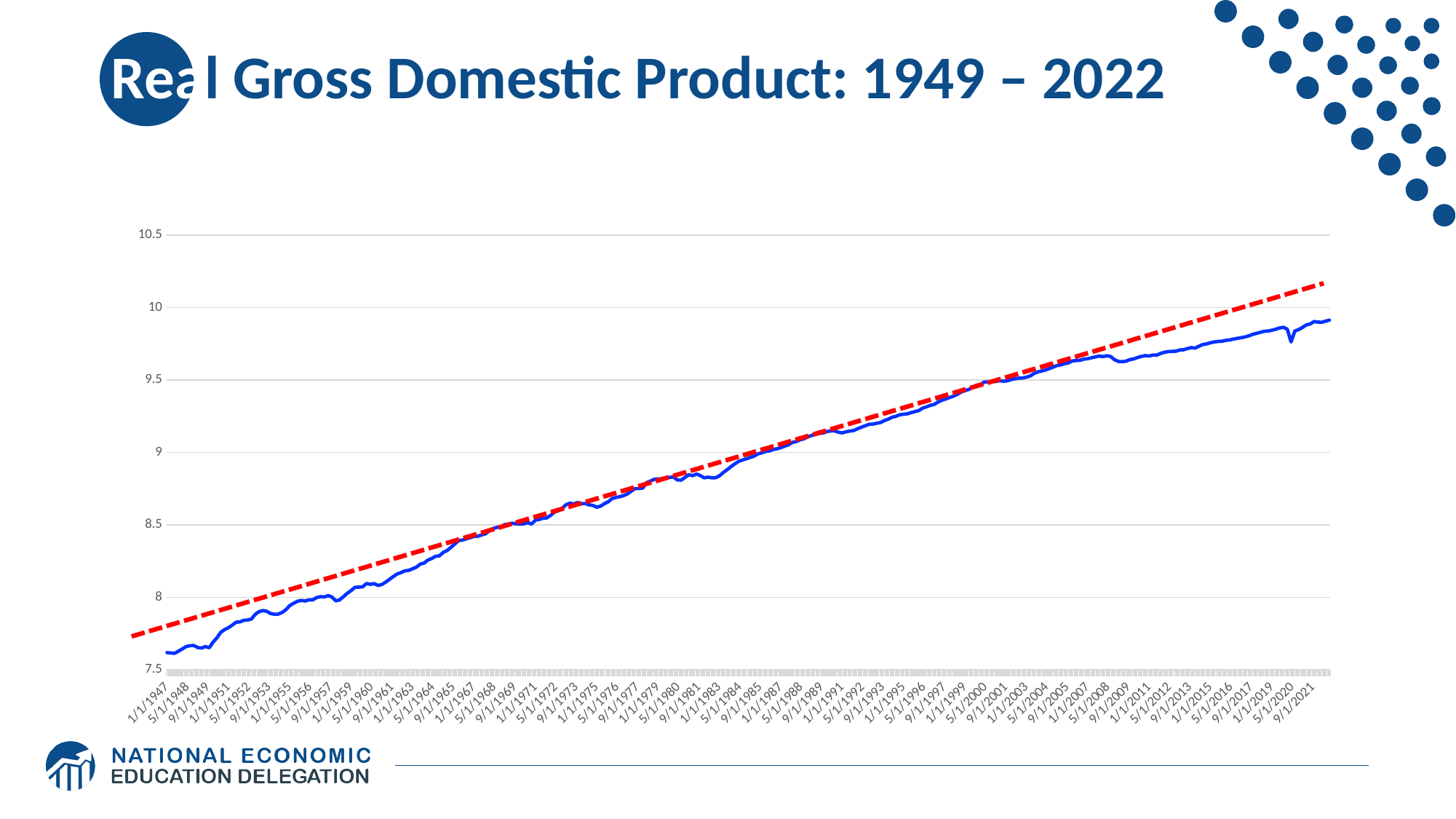
Which is higher at 1/1/1947, the red dashed line or the blue line? the red dashed line Is the value of the blue line at 1/1/1965 greater or less than 8.5? less What is the highest value shown on the y axis? 10.5 What kind of chart is shown on the slide? line chart Is the value of the blue line at 9/1/2021 greater or less than 9.5? greater What is the title of the slide's chart? Real Gross Domestic Product: 1949 – 2022 Does the blue line generally rise or fall from left to right along the x axis? rise Which is larger, the value of the blue line at 1/1/1947 or at 9/1/2021? 9/1/2021 Is the value of the blue line at 9/1/2021 greater or less than 10? less